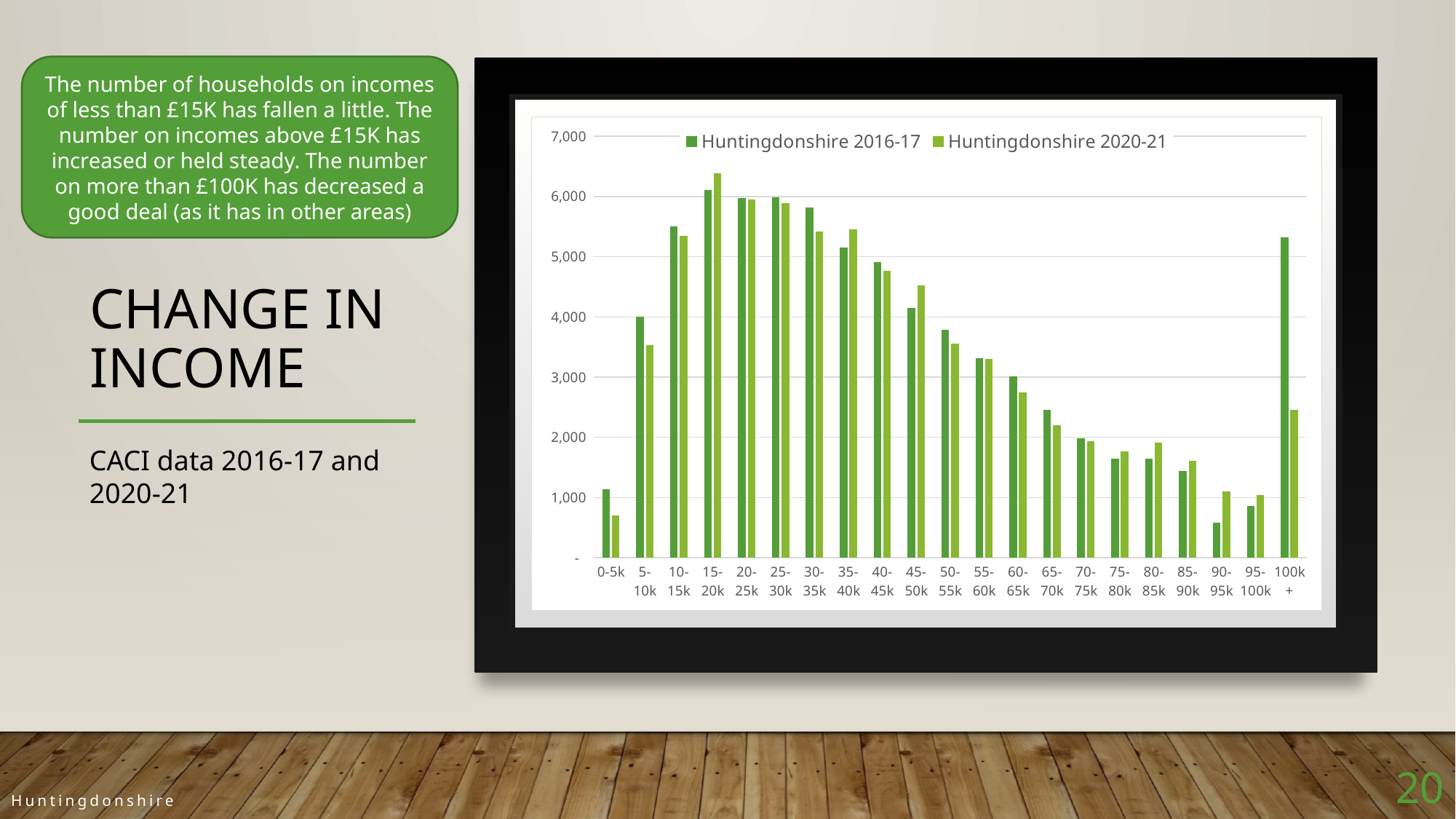
What kind of chart is shown on the slide? bar chart Do the Huntingdonshire 2020-21 values generally rise or fall from the 15-20k band to the 90-95k band? fall Is the value for Huntingdonshire 2020-21 in the 45-50k band greater or less than 4,000? greater For the 15-20k band, which series is larger: Huntingdonshire 2016-17 or Huntingdonshire 2020-21? Huntingdonshire 2020-21 For the 100k+ band, which series is larger: Huntingdonshire 2016-17 or Huntingdonshire 2020-21? Huntingdonshire 2016-17 Which income band has the lowest value for Huntingdonshire 2016-17? 90-95k Is the value for Huntingdonshire 2020-21 in the 0-5k band greater or less than 1,000? less Is the value for Huntingdonshire 2016-17 in the 100k+ band greater or less than 5,000? greater How many series does the chart legend list? 2 Which income band has the highest value for Huntingdonshire 2020-21? 15-20k Which income band has the lowest value for Huntingdonshire 2020-21? 0-5k How many income bands are shown on the x axis of the chart? 21